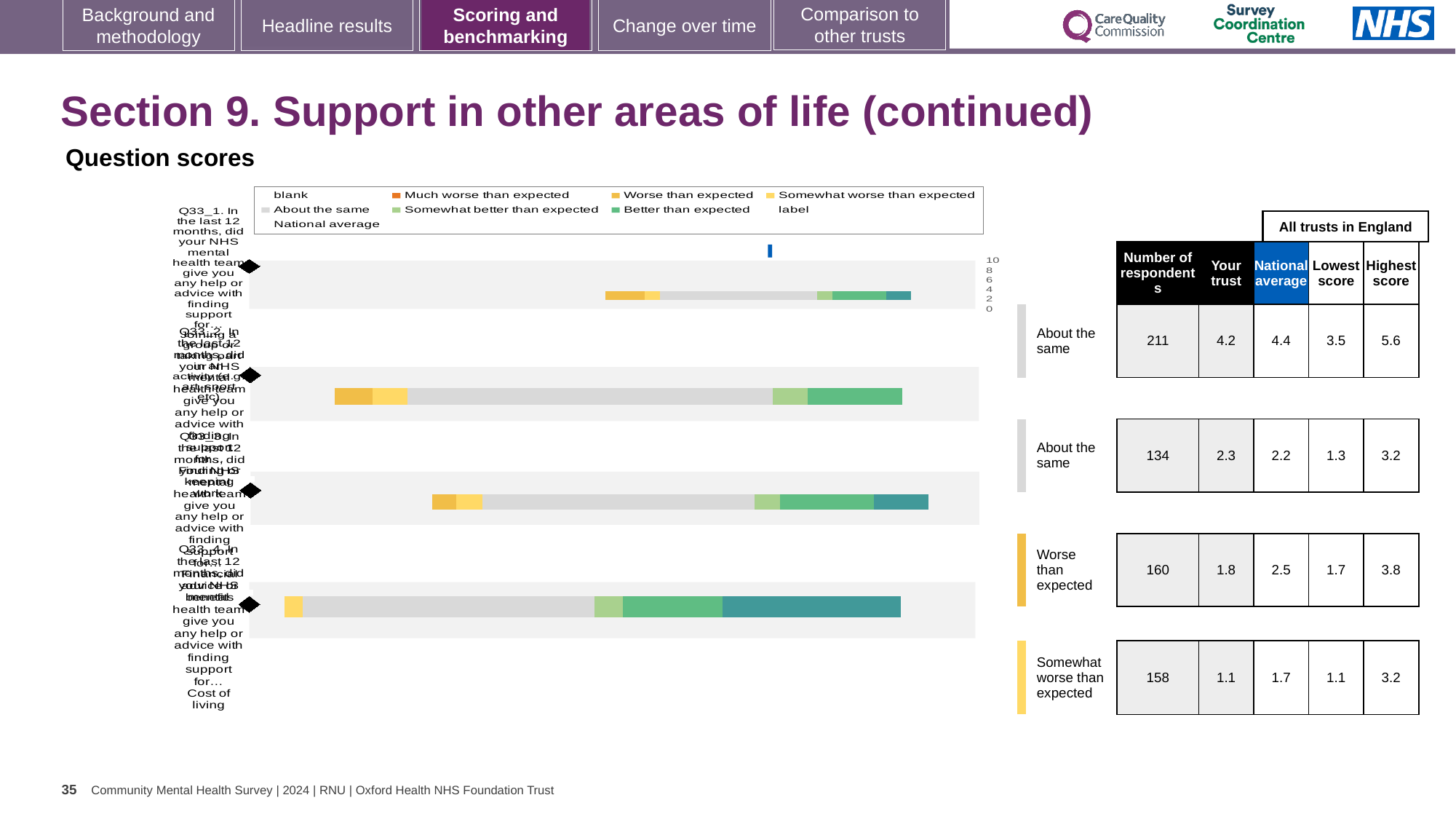
How many bars (questions) are plotted in the question scores chart? 4 What benchmark category label is shown beside the fourth (bottom) bar of the question scores chart? Somewhat worse than expected What kind of chart is shown under 'Question scores'? bar chart In the table beside the question scores chart, what is the national average for the third question? 2.5 In the table beside the question scores chart, which question has the highest number of respondents? the first (top) question, 211 In the table beside the question scores chart, what is the difference between the national average and the 'Your trust' score for the fourth (bottom) question? 0.6 In the table beside the question scores chart, what is the 'Your trust' score for the first (top) question? 4.2 Which legend entry in the question scores chart is shown in dark orange? Much worse than expected How many entries does the legend of the question scores chart list? 9 What benchmark category label is shown beside the third bar of the question scores chart? Worse than expected Which legend entry in the question scores chart is shown in light grey? About the same What benchmark category label is shown beside the first (top) bar of the question scores chart? About the same